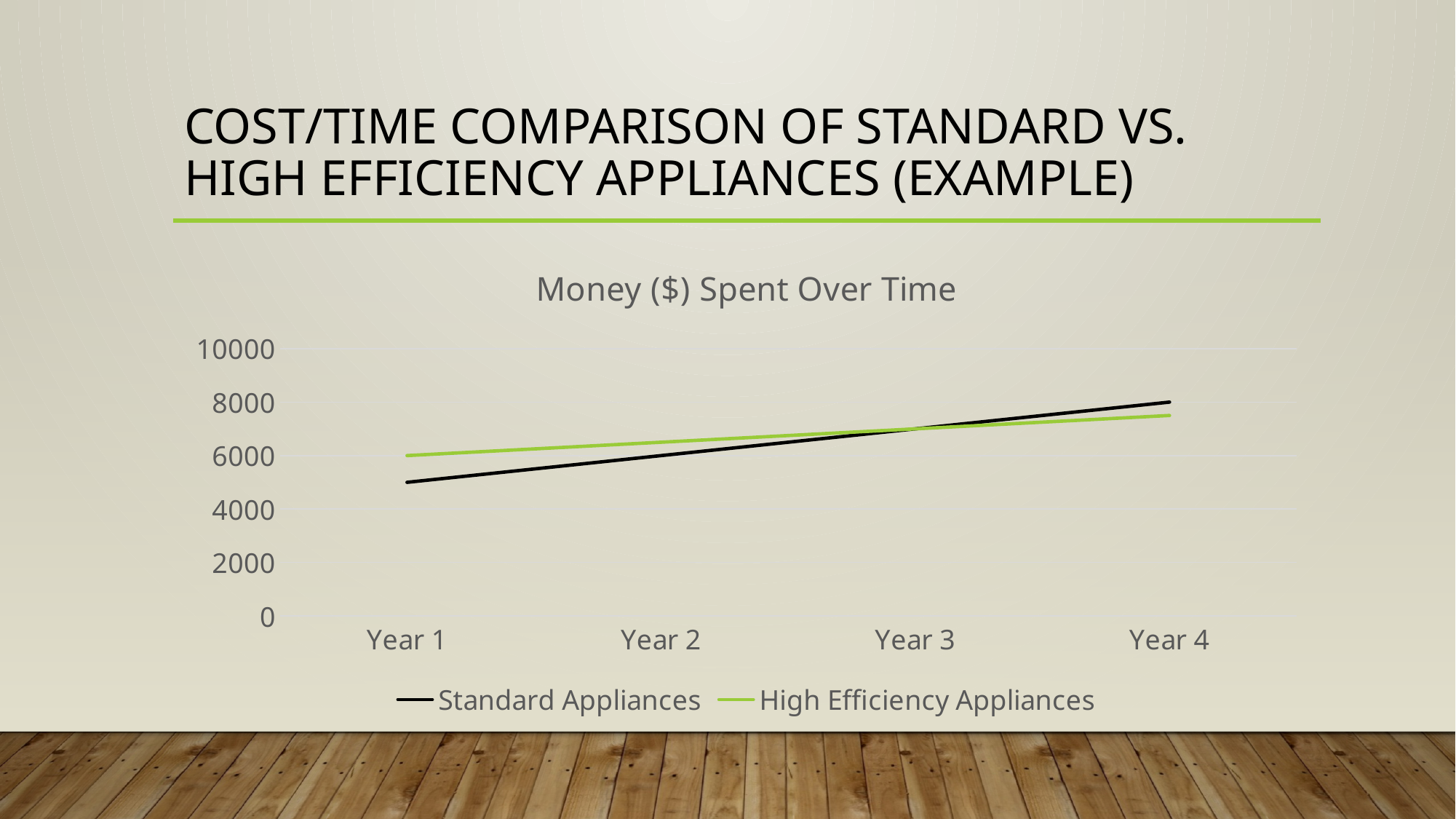
What colour is the line for High Efficiency Appliances? green Is the value for High Efficiency Appliances in Year 4 greater or less than 8000? less In Year 1, which series has the higher value, Standard Appliances or High Efficiency Appliances? High Efficiency Appliances How many series does the legend list? 2 Is the value for Standard Appliances in Year 1 greater or less than 6000? less Is the value for High Efficiency Appliances in Year 1 greater or less than 4000? greater What kind of chart is shown on the slide? line chart How many years are shown along the x axis? 4 What is the title of the chart? Money ($) Spent Over Time Do the values for Standard Appliances rise or fall from Year 1 to Year 4? rise In Year 4, which series has the higher value, Standard Appliances or High Efficiency Appliances? Standard Appliances